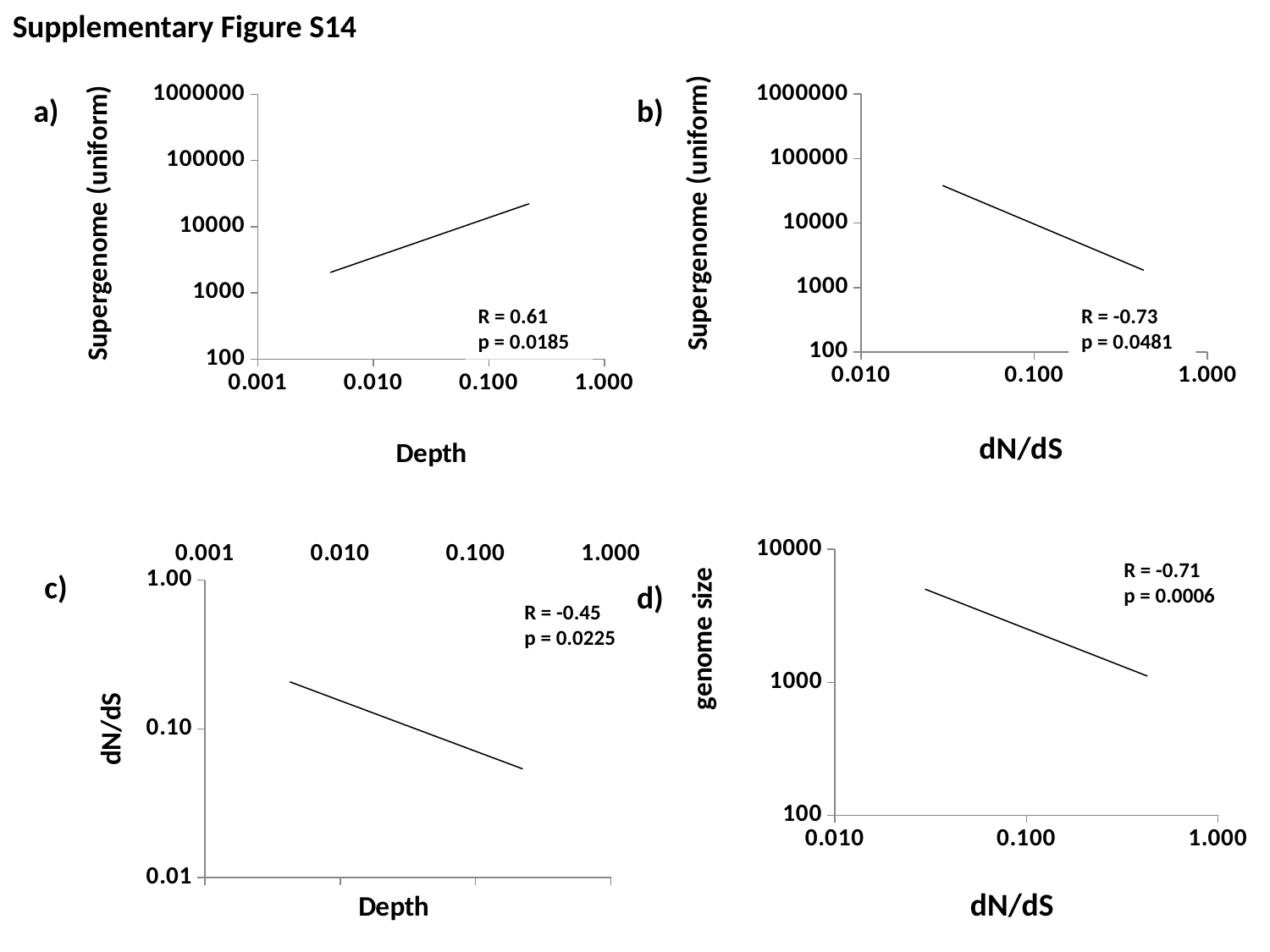
In panel a), is the value of Supergenome (uniform) at Depth 0.010 greater or less than 1000? greater In panel d), is the genome size at dN/dS 0.100 greater or less than 1000? greater In panel b), does Supergenome (uniform) rise or fall as dN/dS increases? fall In panel d), does genome size rise or fall as dN/dS increases? fall In panel a), what is the R value shown? R = 0.61 What is the x-axis label of panel c)? Depth In panel b), what is the p value shown? p = 0.0481 In panel a), does Supergenome (uniform) rise or fall as Depth increases? rise In panel c), what is the R value shown? R = -0.45 What kind of chart is panel d)? line chart In panel d), what is the p value shown? p = 0.0006